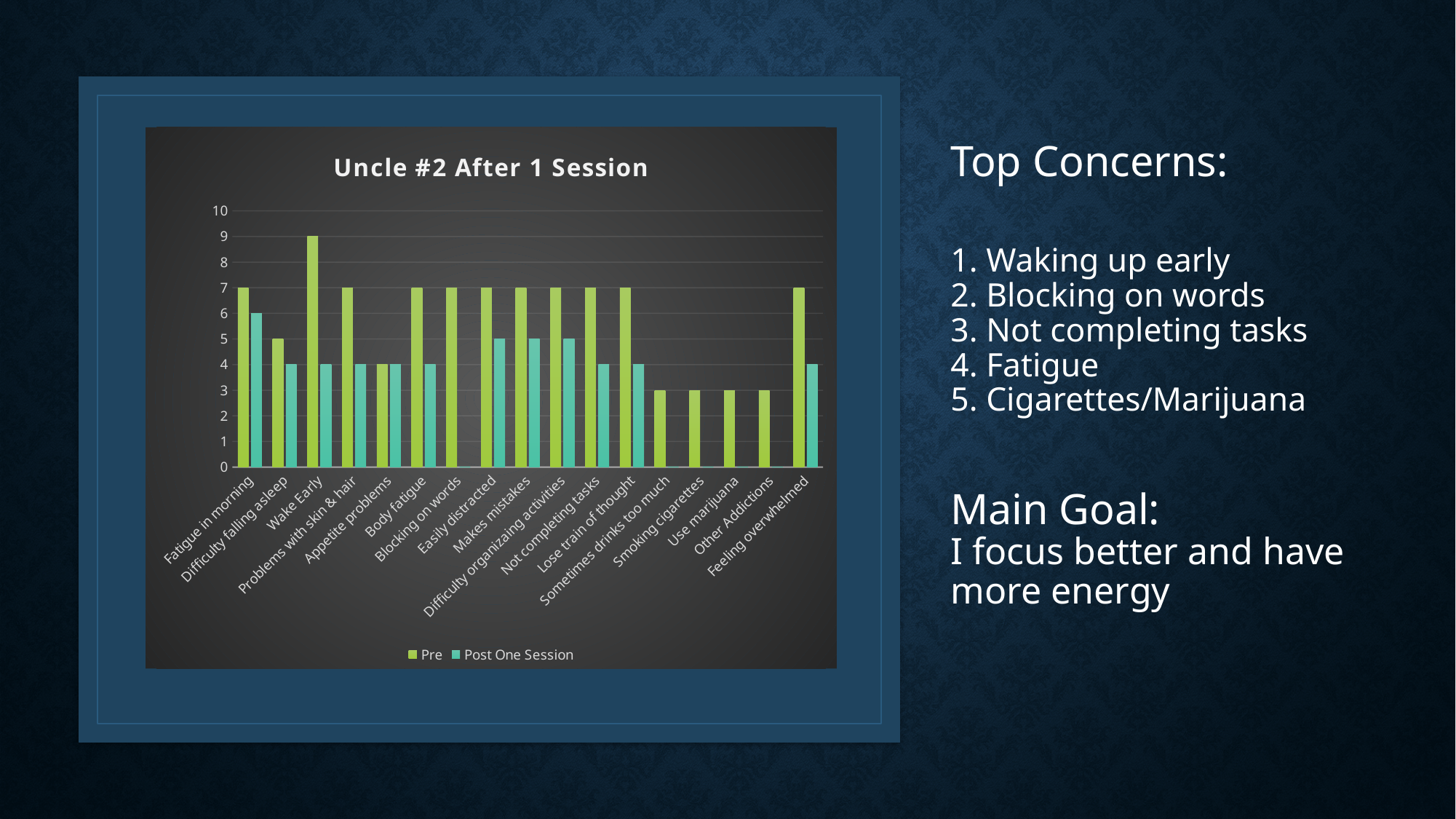
What is the Post One Session value for Fatigue in morning? 6 What is the title of the chart? Uncle #2 After 1 Session What is the Pre value for Wake Early? 9 How many series does the chart legend list? 2 Is the Pre value for Smoking cigarettes greater or less than 5? less What type of chart is shown on the slide? Bar chart How many categories are shown along the x axis of the chart? 17 Which category has the highest Pre value? Wake Early Which is larger for Easily distracted: the Pre value or the Post One Session value? Pre What is the Post One Session value for Wake Early? 4 Which category has the highest Post One Session value? Fatigue in morning What is the difference between the Pre and Post One Session values for Wake Early? 5